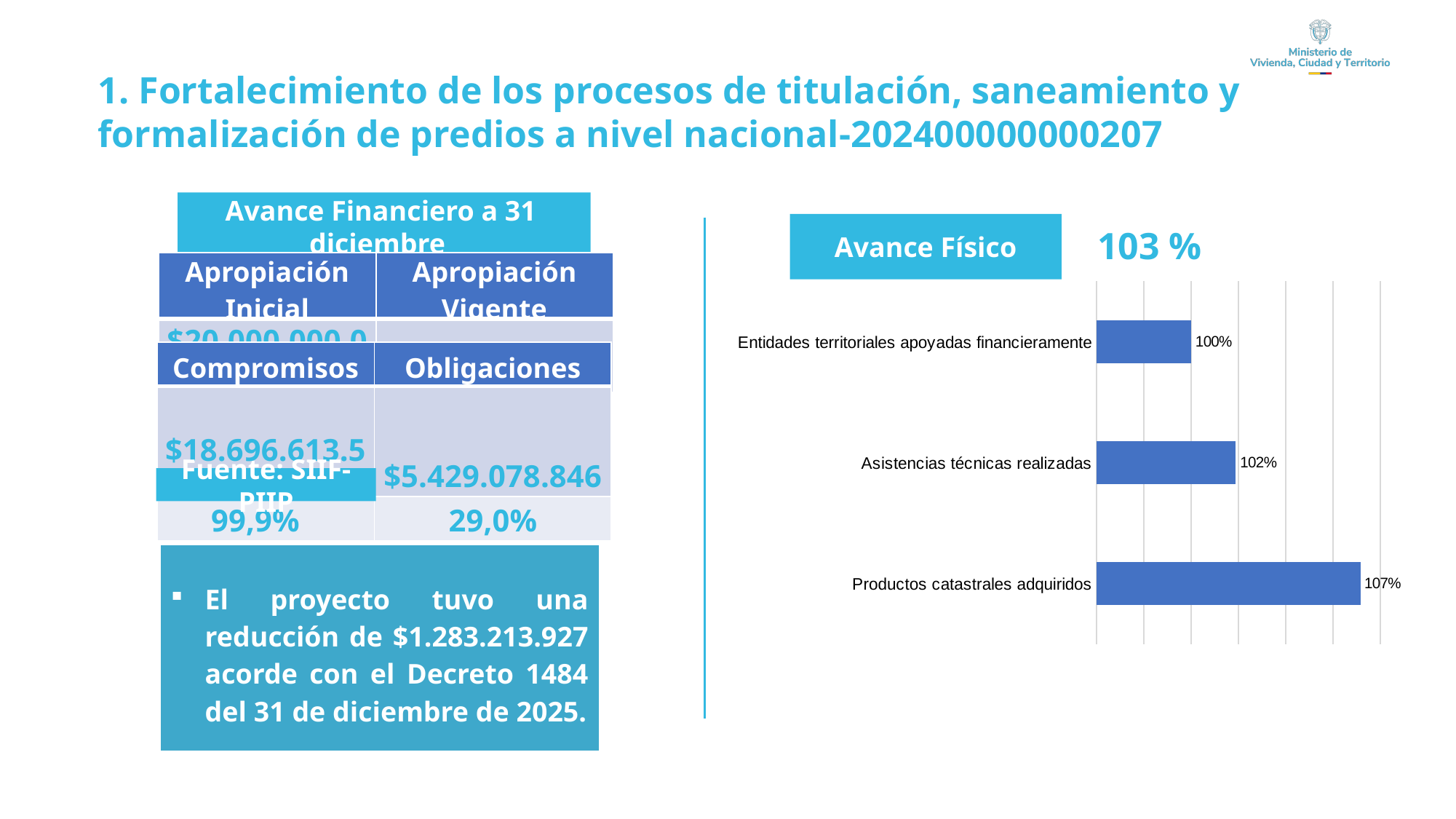
What kind of chart is the Avance Físico chart? Bar chart What colour are the bars in the Avance Físico chart? Blue How many categories are shown in the Avance Físico chart? 3 What is the value for Entidades territoriales apoyadas financieramente in the Avance Físico chart? 100% What is the difference between the values for Productos catastrales adquiridos and Asistencias técnicas realizadas in the Avance Físico chart? 5% In the Avance Físico chart, which is larger: Asistencias técnicas realizadas or Entidades territoriales apoyadas financieramente? Asistencias técnicas realizadas What is the value for Productos catastrales adquiridos in the Avance Físico chart? 107% Which category has the highest value in the Avance Físico chart? Productos catastrales adquiridos Which category has the lowest value in the Avance Físico chart? Entidades territoriales apoyadas financieramente What is the difference between the values for Productos catastrales adquiridos and Entidades territoriales apoyadas financieramente in the Avance Físico chart? 7% What is the value for Asistencias técnicas realizadas in the Avance Físico chart? 102% What is the overall Avance Físico percentage shown next to the chart heading? 103 %